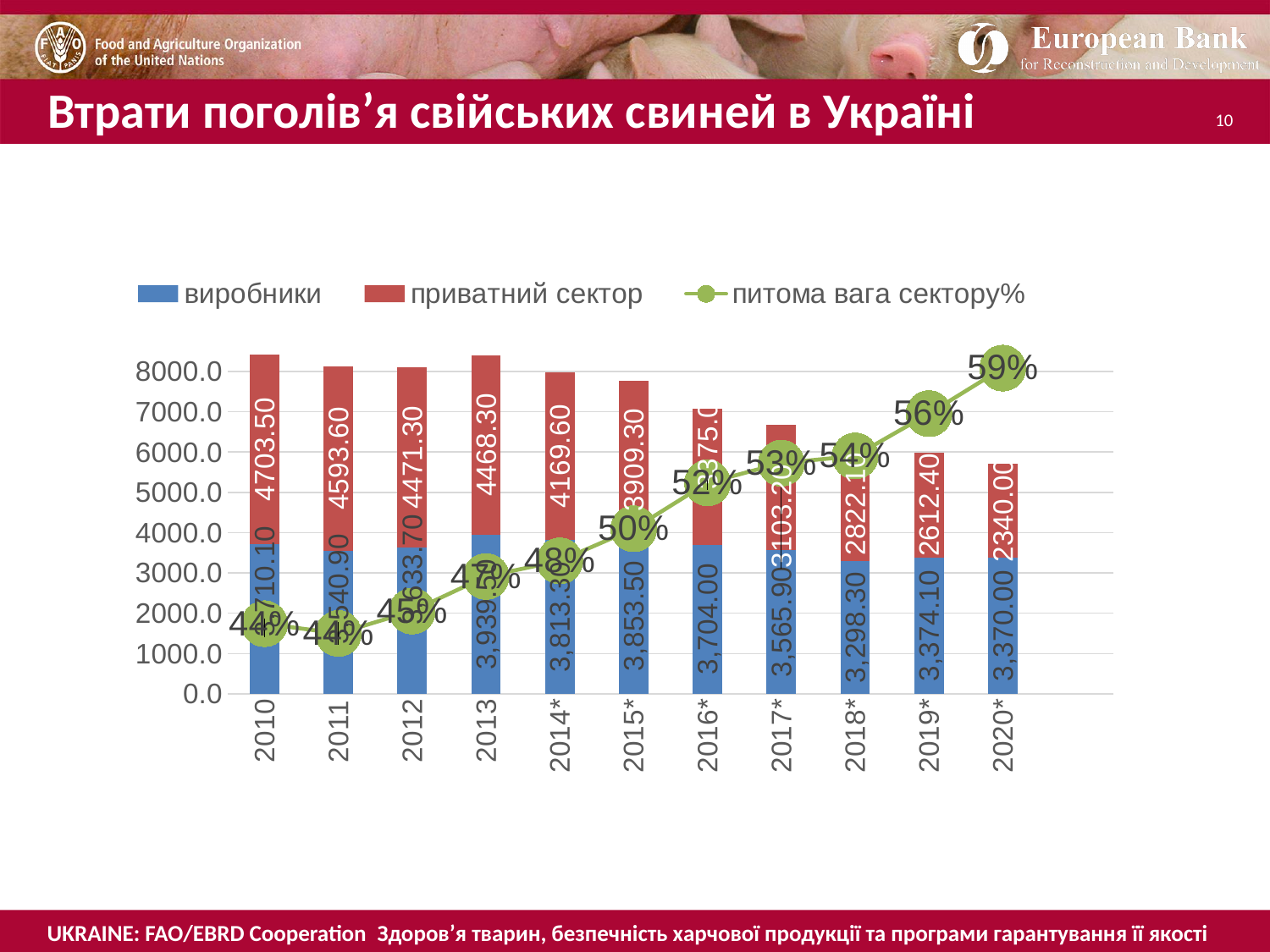
What is the питома вага сектору% value for 2020*? 59% Does the питома вага сектору% line rise or fall from 2010 to 2020*? rises In which year is the приватний сектор value lowest? 2020* How many series does the legend list? 3 What is the value for виробники in 2016*? 3,704.00 What is the difference between the приватний сектор values for 2010 and 2020*? 2363.50 How many years are shown on the x axis? 11 What is the value for приватний сектор in 2010? 4703.50 What is the value for приватний сектор in 2020*? 2340.00 Which is larger, the виробники value for 2018* or for 2019*? 2019* In which year is the приватний сектор value highest? 2010 What is the total of the stacked bar for 2020* (виробники plus приватний сектор)? 5710.00